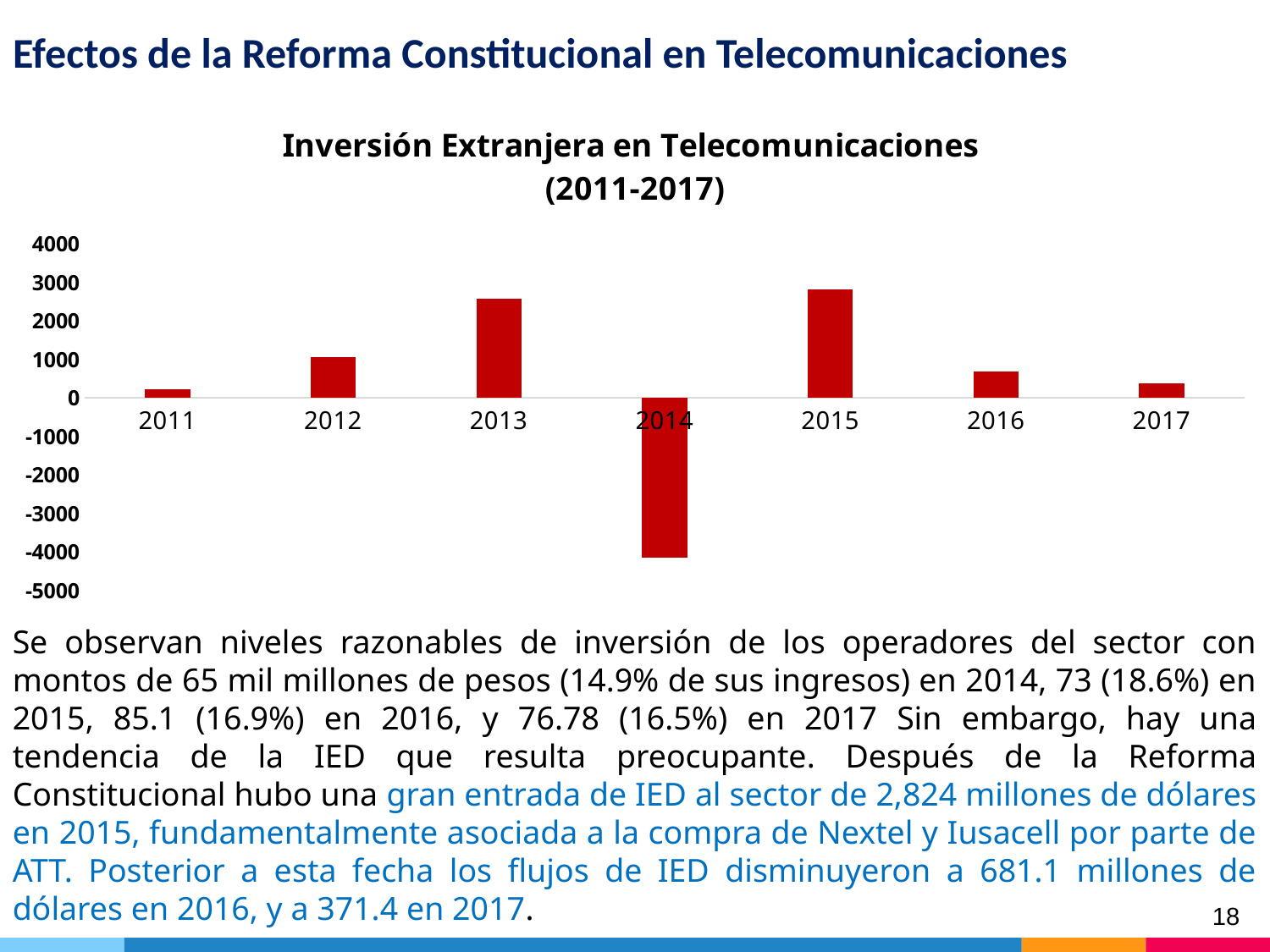
From 2015 to 2017, do the values rise or fall? fall Is the value for 2013 greater or less than 2000? greater How many years are shown on the x axis of the chart? 7 Which year has the highest value in the chart? 2015 Is the value for 2014 greater or less than -3000? less Which year has the larger value, 2012 or 2013? 2013 Is the value for 2016 greater or less than 1000? less Which year has the lowest value in the chart? 2014 What kind of chart is shown on the slide? bar chart Which year has the larger value, 2016 or 2017? 2016 What is the title of the chart? Inversión Extranjera en Telecomunicaciones (2011-2017)